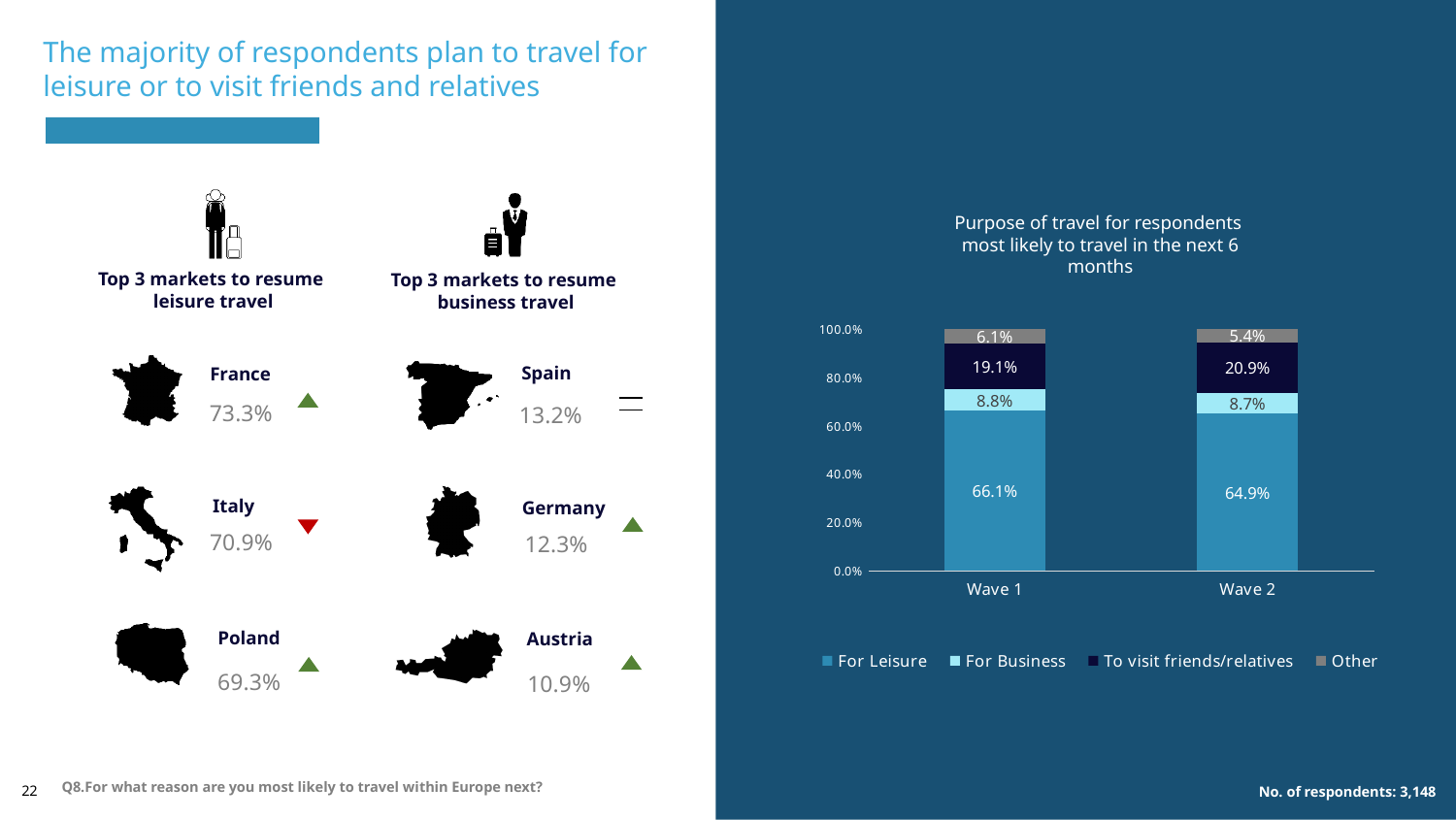
In the chart 'Purpose of travel for respondents most likely to travel in the next 6 months', by how many percentage points does 'For Leisure' differ between Wave 1 and Wave 2? 1.2 percentage points What type of chart is 'Purpose of travel for respondents most likely to travel in the next 6 months'? Stacked bar chart In the chart 'Purpose of travel for respondents most likely to travel in the next 6 months', how many waves are shown on the x axis? 2 In the chart 'Purpose of travel for respondents most likely to travel in the next 6 months', what percentage of Wave 1 respondents plan to travel For Leisure? 66.1% In the chart 'Purpose of travel for respondents most likely to travel in the next 6 months', what is the value for 'Other' in Wave 2? 5.4% In the chart 'Purpose of travel for respondents most likely to travel in the next 6 months', what is the value for 'To visit friends/relatives' in Wave 2? 20.9% In the chart 'Purpose of travel for respondents most likely to travel in the next 6 months', is the 'To visit friends/relatives' share larger in Wave 1 or Wave 2? Wave 2 In the chart 'Purpose of travel for respondents most likely to travel in the next 6 months', does the 'For Leisure' share rise or fall from Wave 1 to Wave 2? Fall In the chart 'Purpose of travel for respondents most likely to travel in the next 6 months', what is the value for 'For Business' in Wave 1? 8.8% In the chart 'Purpose of travel for respondents most likely to travel in the next 6 months', which purpose has the smallest share in Wave 2? Other In the chart 'Purpose of travel for respondents most likely to travel in the next 6 months', how many series does the legend list? 4 In the chart 'Purpose of travel for respondents most likely to travel in the next 6 months', which purpose has the largest share in Wave 1? For Leisure